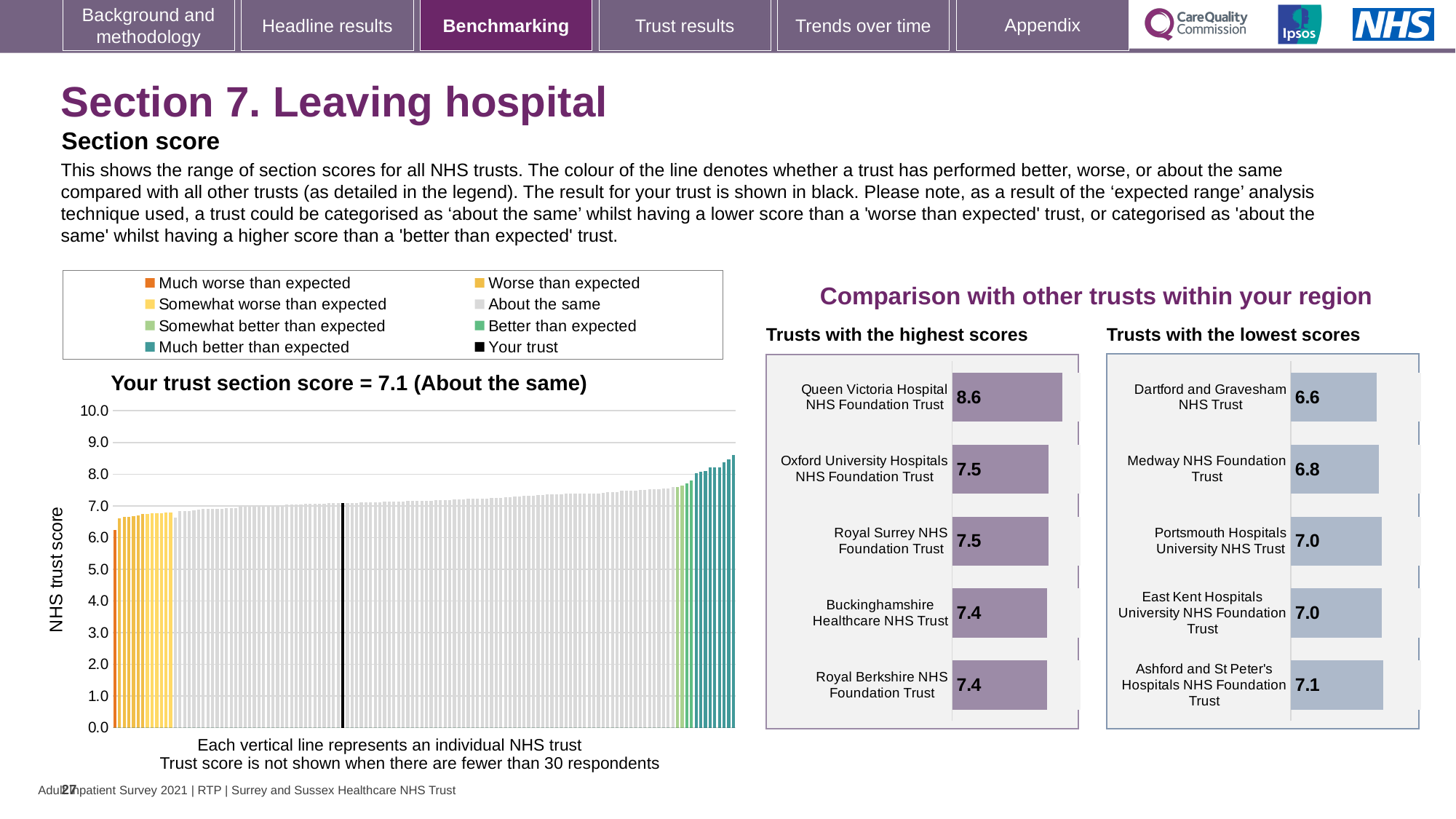
What is the section score for your trust shown in the main chart on the left? 7.1 In the 'Trusts with the highest scores' chart, what is the score for Queen Victoria Hospital NHS Foundation Trust? 8.6 In the 'Trusts with the lowest scores' chart, which has the larger score: Medway NHS Foundation Trust or Dartford and Gravesham NHS Trust? Medway NHS Foundation Trust In the 'Trusts with the highest scores' chart, what is the difference between the scores of Queen Victoria Hospital NHS Foundation Trust and Buckinghamshire Healthcare NHS Trust? 1.2 How many entries does the legend above the main chart on the left list? 8 In the 'Trusts with the lowest scores' chart, what is the score for Medway NHS Foundation Trust? 6.8 What kind of chart is the main chart on the left showing the range of section scores? Bar chart In the 'Trusts with the highest scores' chart, which trust has the highest score? Queen Victoria Hospital NHS Foundation Trust In the main chart on the left, do the trust scores rise or fall from left to right along the x axis? Rise In the 'Trusts with the lowest scores' chart, which trust has the lowest score? Dartford and Gravesham NHS Trust In the 'Trusts with the lowest scores' chart, what is the difference between the scores of Ashford and St Peter's Hospitals NHS Foundation Trust and Dartford and Gravesham NHS Trust? 0.5 How many trusts are shown in the 'Trusts with the highest scores' chart? 5